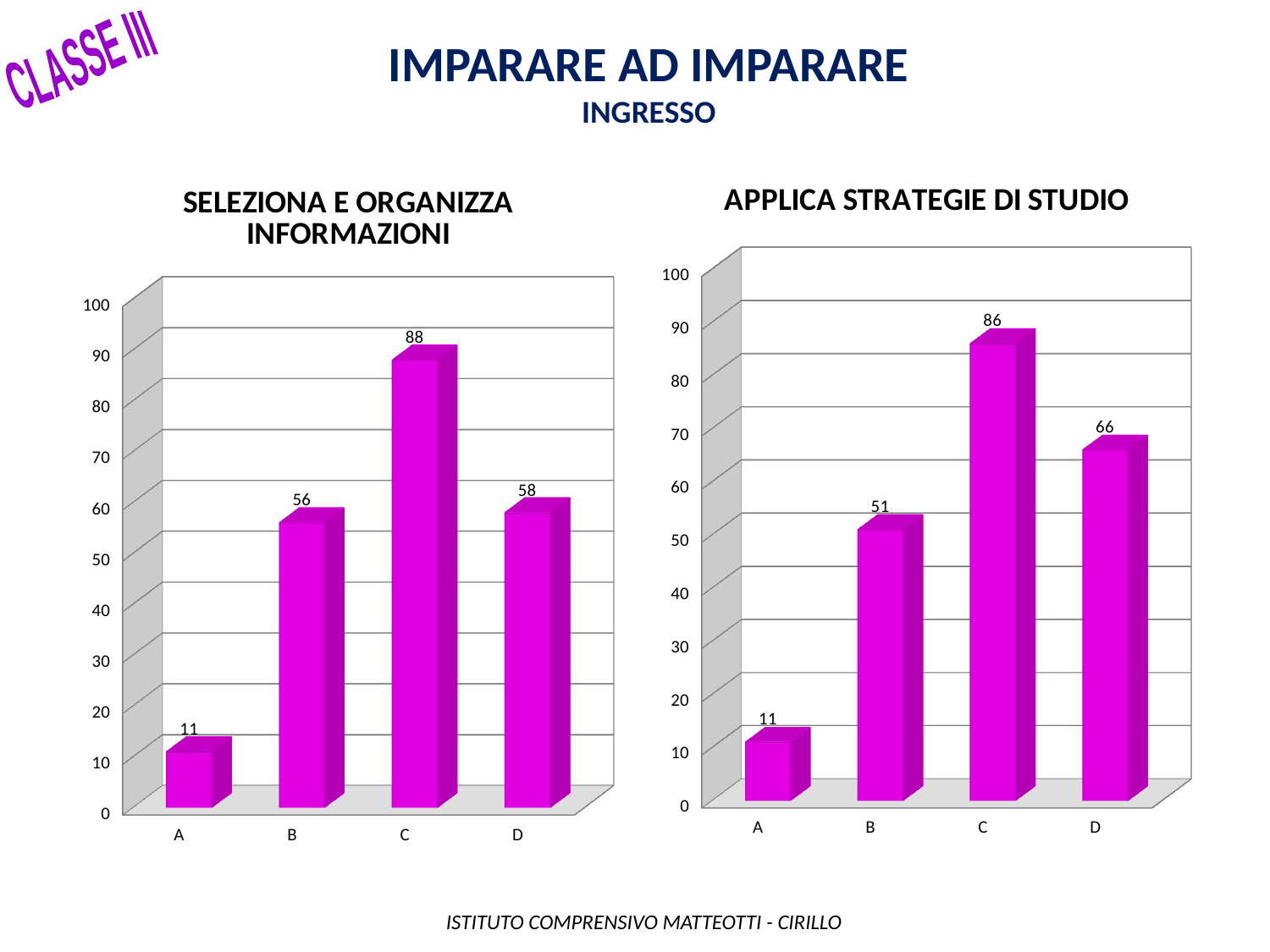
In the 'SELEZIONA E ORGANIZZA INFORMAZIONI' chart, what is the difference between the values for C and B? 32 In the 'APPLICA STRATEGIE DI STUDIO' chart, what is the difference between the values for D and B? 15 In the 'APPLICA STRATEGIE DI STUDIO' chart, which is larger, the value for B or the value for D? D In the 'SELEZIONA E ORGANIZZA INFORMAZIONI' chart, what is the value for category C? 88 In the 'APPLICA STRATEGIE DI STUDIO' chart, what is the value for category D? 66 What kind of chart is the 'SELEZIONA E ORGANIZZA INFORMAZIONI' chart? Bar chart In the 'SELEZIONA E ORGANIZZA INFORMAZIONI' chart, which category has the lowest value? A What is the title of the chart on the right side of the slide? APPLICA STRATEGIE DI STUDIO How many categories are shown in the 'APPLICA STRATEGIE DI STUDIO' chart? 4 In the 'SELEZIONA E ORGANIZZA INFORMAZIONI' chart, what is the value for category B? 56 In the 'SELEZIONA E ORGANIZZA INFORMAZIONI' chart, is the value for D greater or less than 50? greater In the 'APPLICA STRATEGIE DI STUDIO' chart, which category has the highest value? C